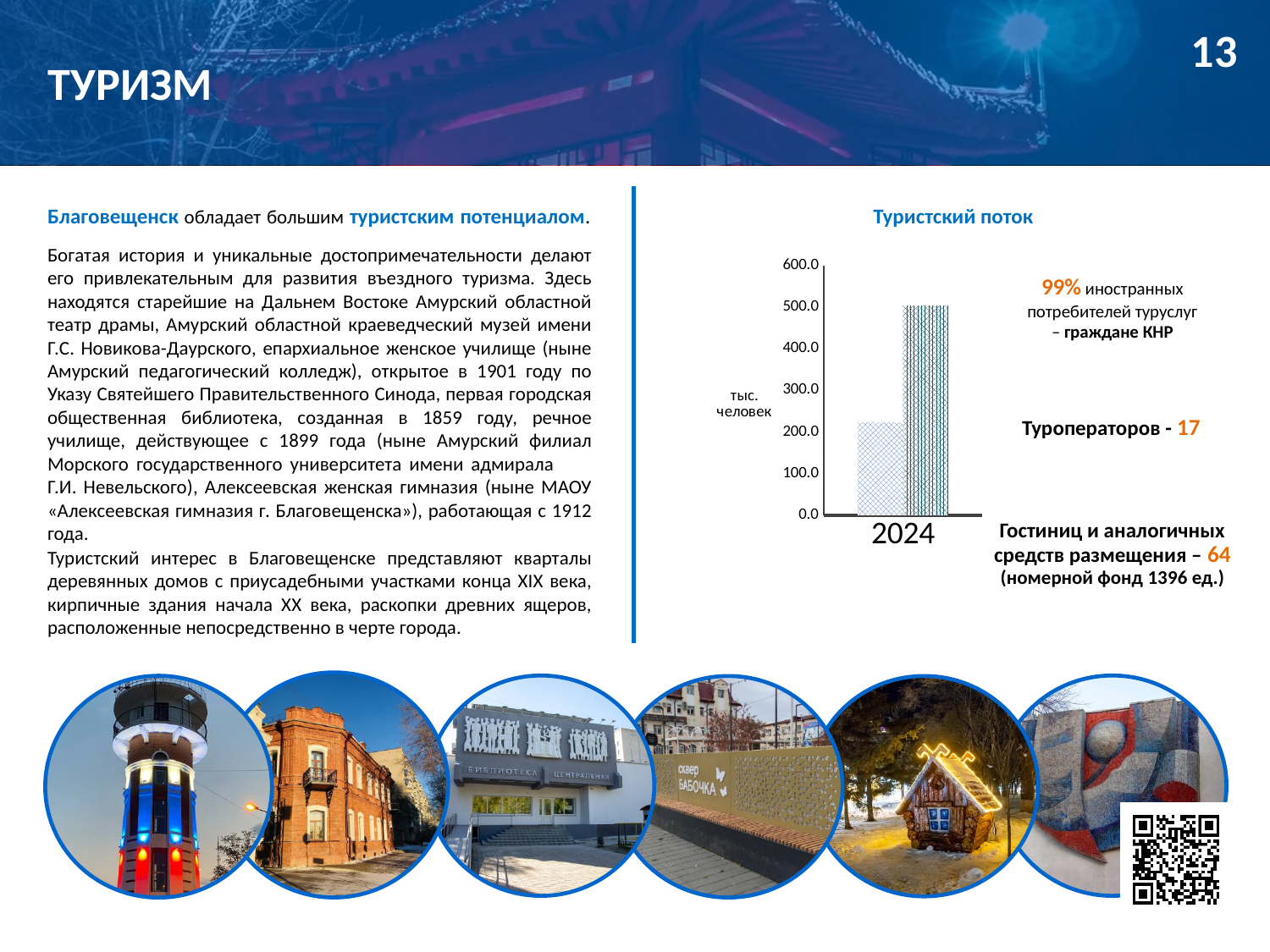
What category label appears on the x axis of the "Туристский поток" chart? 2024 In the "Туристский поток" chart, is the value of the left (light blue) bar greater or less than 100? greater How many categories are shown on the x axis of the "Туристский поток" chart? 1 In the "Туристский поток" chart, is the value of the right (hatched) bar greater or less than 400? greater In the "Туристский поток" chart, which bar is taller, the left light blue bar or the right hatched bar? the right hatched bar In the "Туристский поток" chart, is the value of the left (light blue) bar greater or less than 300? less What is the highest value shown on the y axis of the "Туристский поток" chart? 600.0 What is the title of the chart on the right side of the slide? Туристский поток What kind of chart is shown under the title "Туристский поток"? bar chart